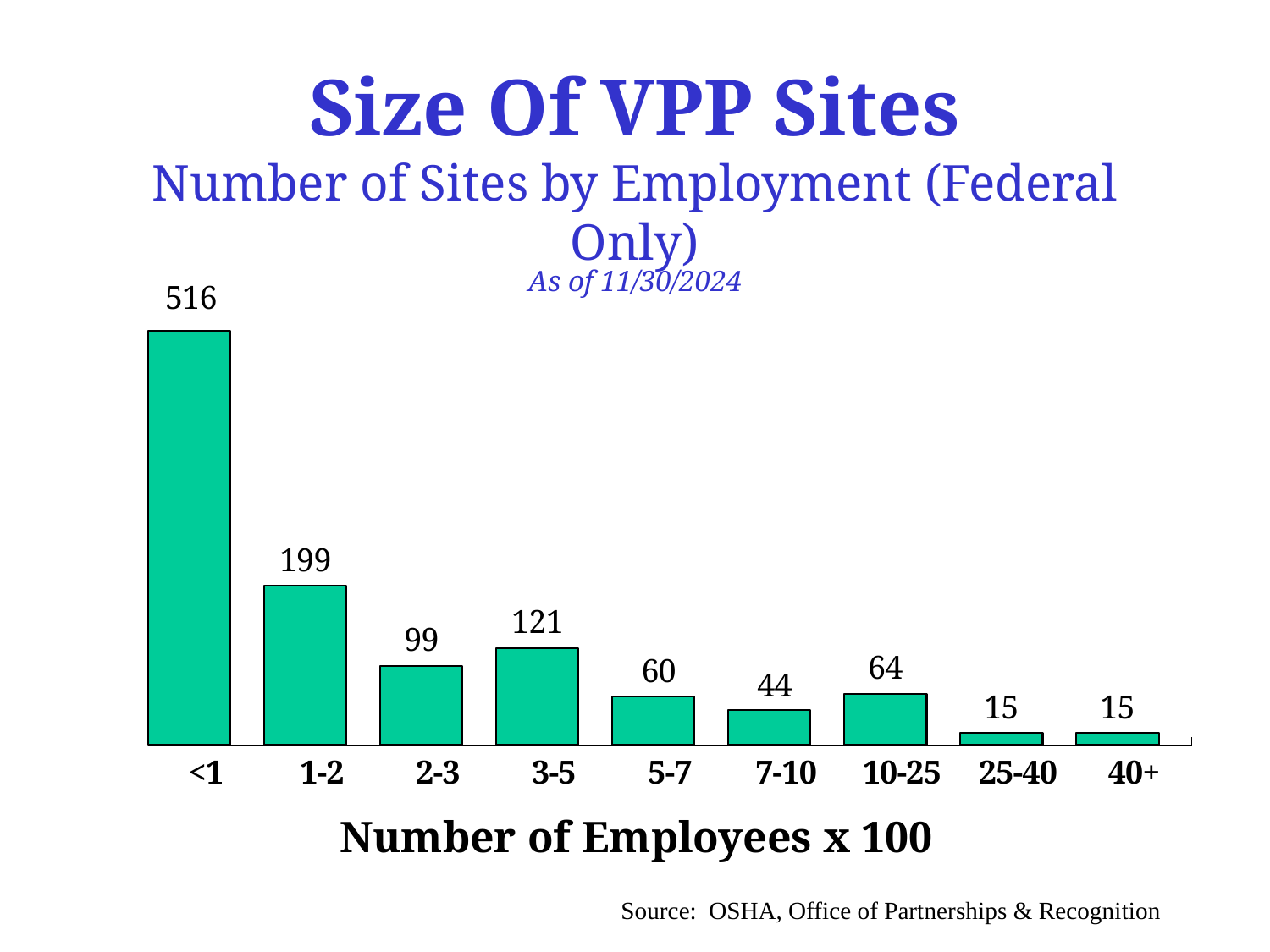
Which employment category has the lowest number of sites? 25-40 and 40+ (both 15) Which employment category has the highest number of sites? <1 Which has more sites, the '5-7' category or the '10-25' category? 10-25 How many employment categories are shown on the x axis? 9 What is the number of sites in the '3-5' employment category? 121 What is the difference between the number of sites in the '<1' category and the '1-2' category? 317 What type of chart is shown on the slide? Bar chart What is the 'as of' date shown for the chart data? 11/30/2024 What is the number of sites in the '10-25' employment category? 64 How many VPP sites have fewer than 100 employees (the '<1' category)? 516 What is the difference between the number of sites in the '3-5' category and the '2-3' category? 22 What is the x-axis label of the chart? Number of Employees x 100